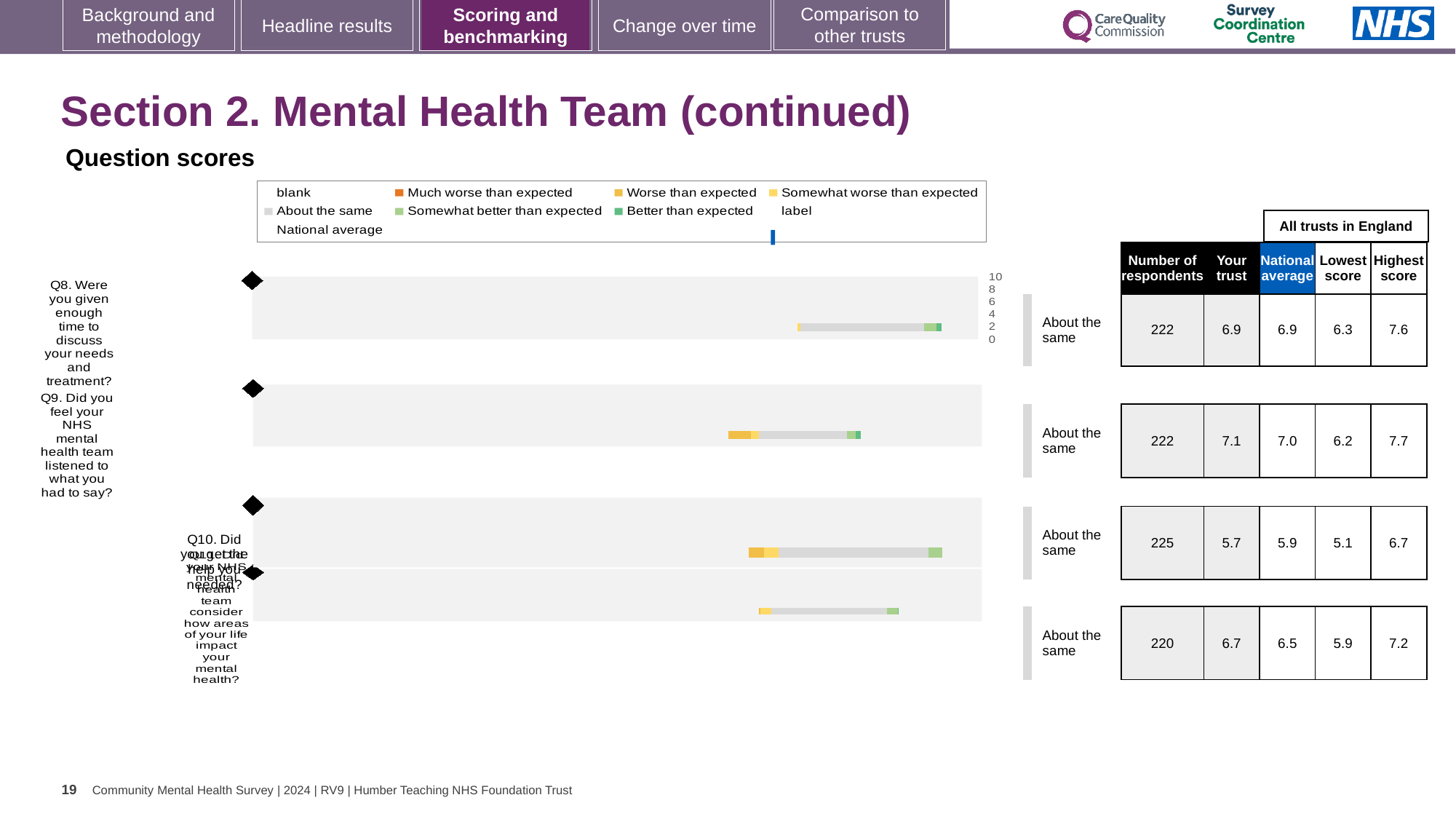
Which question has the highest 'Your trust' score? Q9 Which question has the lowest 'Your trust' score? Q10 How many respondents are listed for Q9 (Did you feel your NHS mental health team listened to what you had to say?)? 222 What benchmark category is shown next to the bar for Q8? About the same What is the 'Your trust' score for Q8 (Were you given enough time to discuss your needs and treatment?)? 6.9 What is the national average score for Q10 (Did you get the help you needed?)? 5.9 For Q10, what is the difference between the highest score (6.7) and the lowest score (5.1) among all trusts in England? 1.6 How many questions (bars) are plotted in the question scores chart? 4 What kind of chart is used to show the question scores on this slide? bar chart Which is larger: the 'Your trust' score for Q8 or for Q10? Q8 What is the highest score among all trusts in England for the fourth question (Q11)? 7.2 What colour does the legend use for 'Much worse than expected'? orange